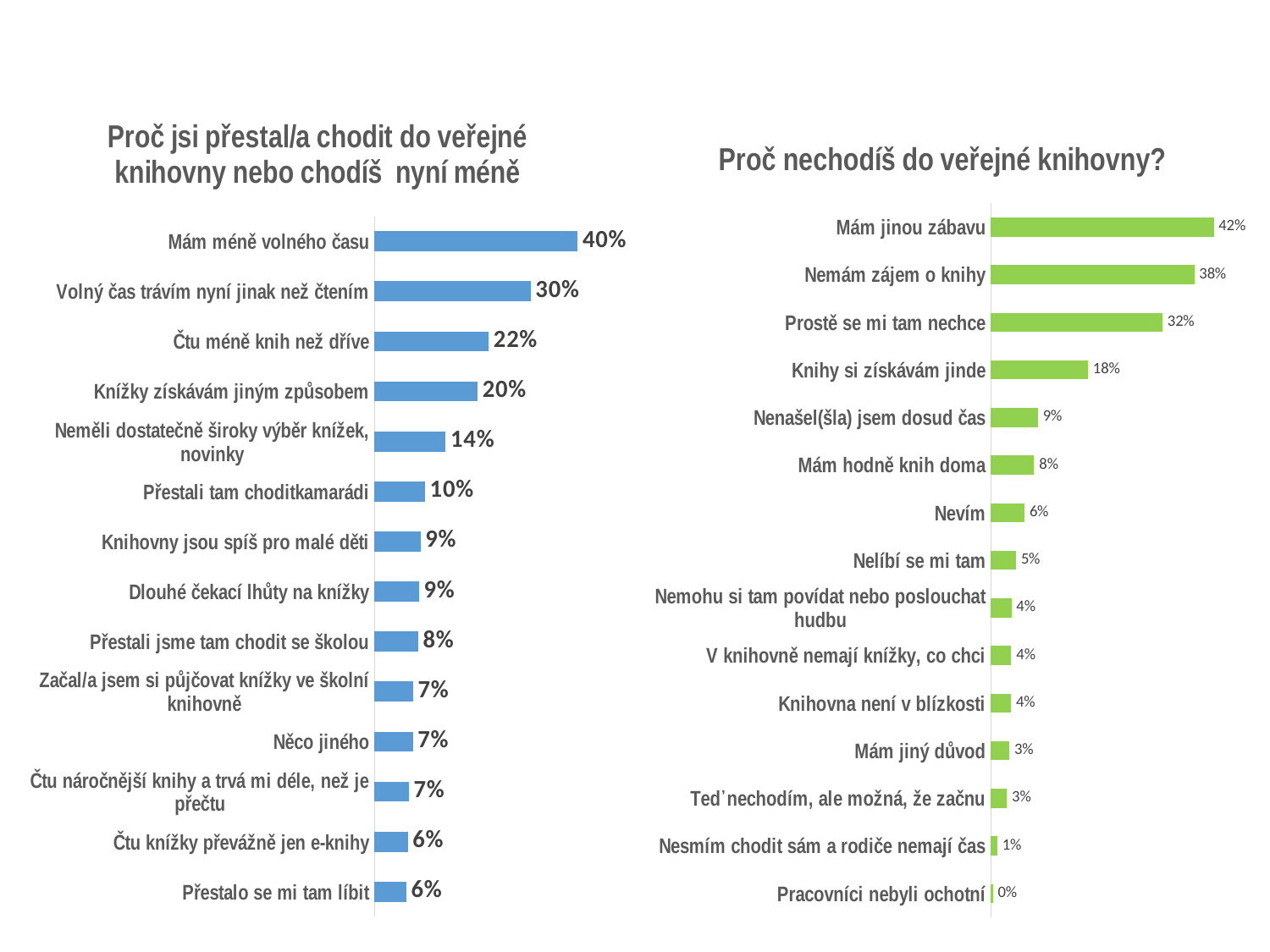
In the left chart, which category has the highest value? Mám méně volného času In the right chart, what is the difference between 'Mám jinou zábavu' and 'Prostě se mi tam nechce'? 10% In the right chart, which category has the highest value? Mám jinou zábavu In the right chart 'Proč nechodíš do veřejné knihovny?', what is the value for 'Nemám zájem o knihy'? 38% What type of chart is the left chart? Bar chart In the left chart, what is the difference between 'Mám méně volného času' and 'Volný čas trávím nyní jinak než čtením'? 10% In the left chart 'Proč jsi přestal/a chodit do veřejné knihovny nebo chodíš nyní méně', what is the value for 'Mám méně volného času'? 40% How many categories does the right chart 'Proč nechodíš do veřejné knihovny?' show? 15 In the right chart, what is the value for 'Knihy si získávám jinde'? 18% In the left chart, what is the value for 'Knížky získávám jiným způsobem'? 20% In the left chart, which is larger: 'Čtu méně knih než dříve' or 'Přestali tam chodit kamarádi'? Čtu méně knih než dříve In the right chart, which category has the lowest value? Pracovníci nebyli ochotní